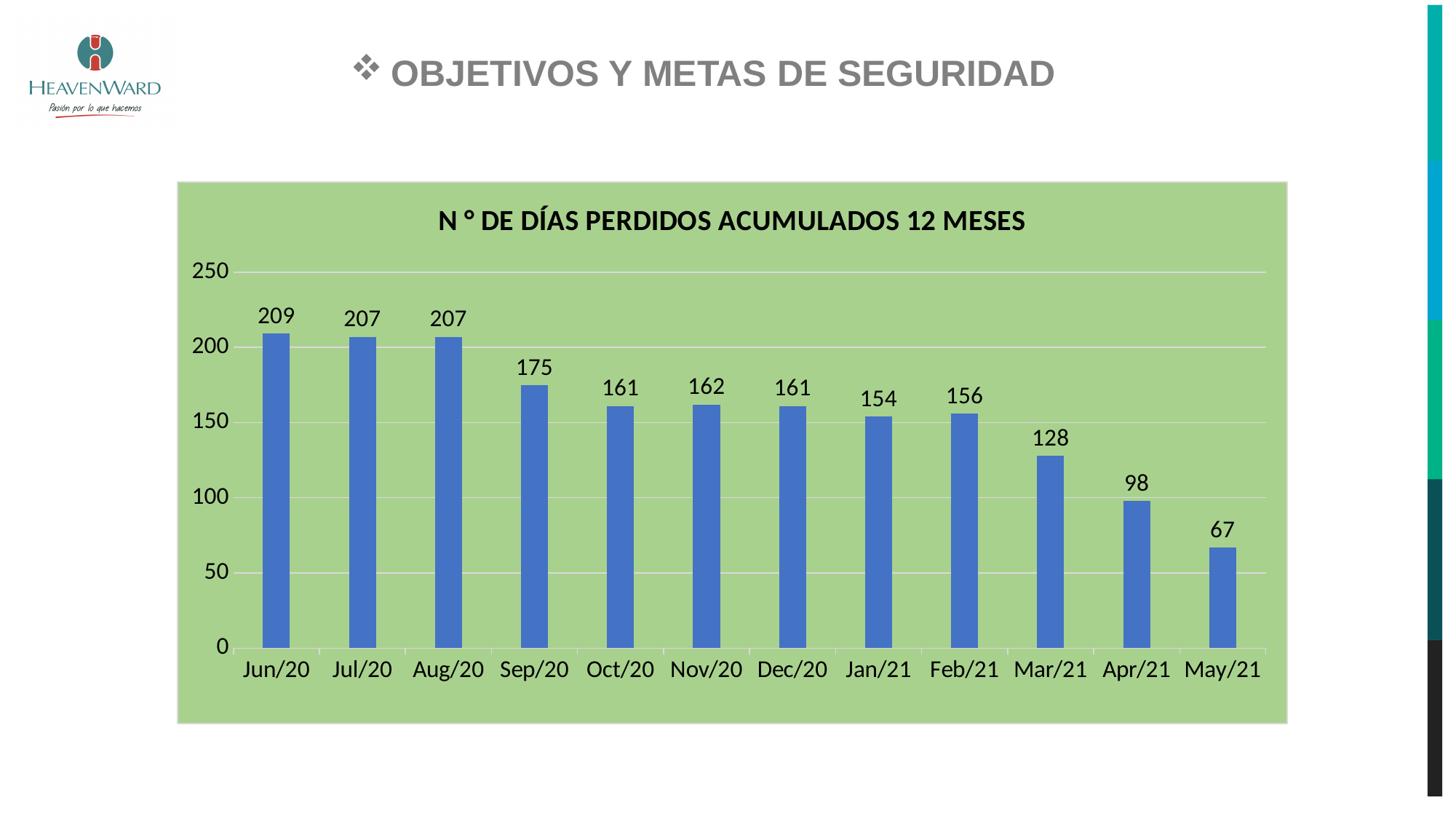
What is the value for Sep/20? 175 What is the difference between the values for Feb/21 and Mar/21? 28 What is the value for May/21? 67 Which month has the highest value? Jun/20 How many months are shown on the x axis? 12 What kind of chart is shown on the slide? Bar chart Is the value for Jan/21 greater or less than 150? greater Which is larger, the value for Sep/20 or the value for Apr/21? Sep/20 What is the value for Mar/21? 128 Do the values generally rise or fall from Jun/20 to May/21? Fall What is the difference between the values for Jun/20 and May/21? 142 Which month has the lowest value? May/21